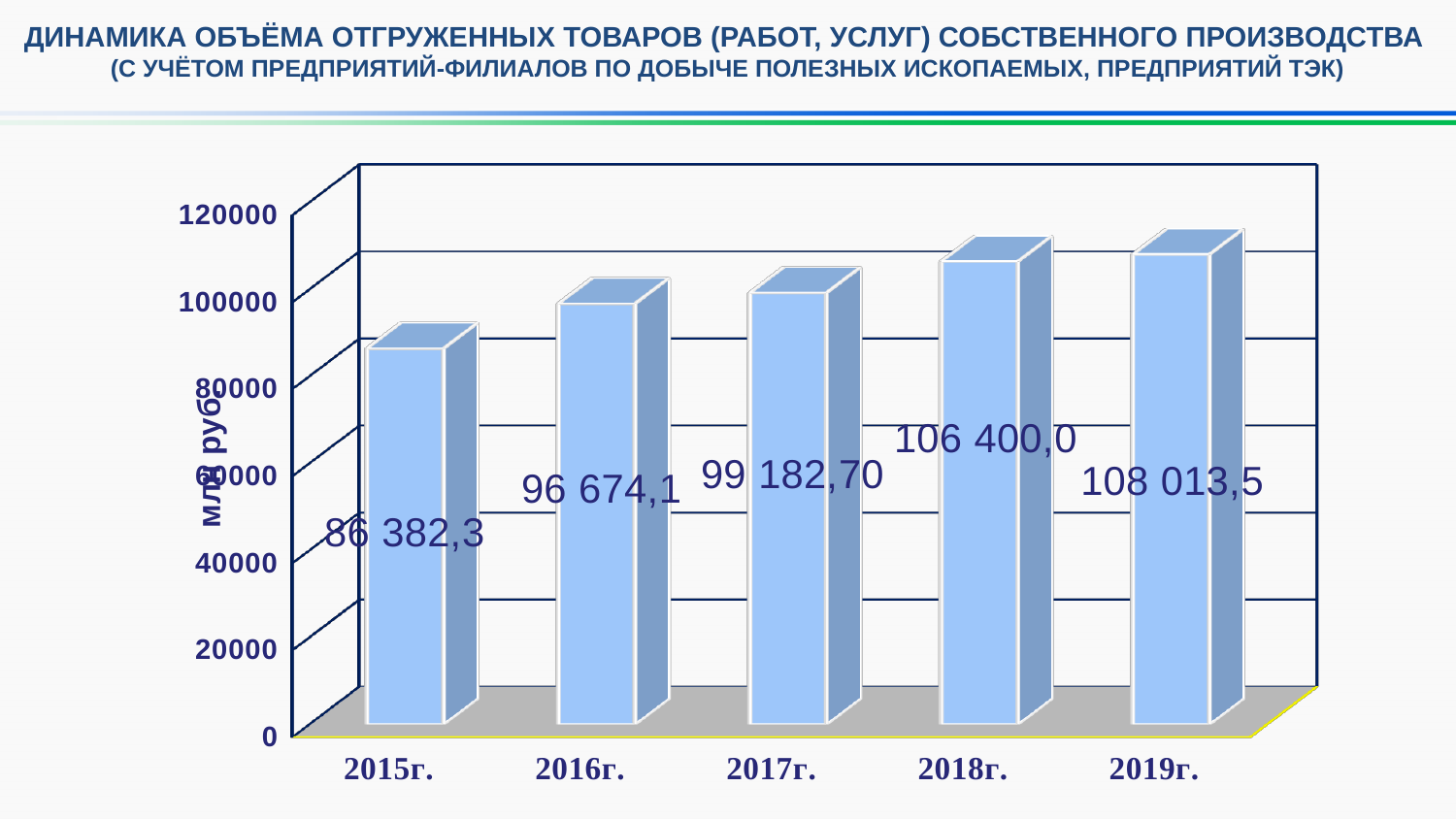
How many years are shown on the x axis? 5 Which is larger, the value for 2017г. or the value for 2018г.? 2018г. Which year has the lowest value? 2015г. Which year has the highest value? 2019г. What is the difference between the values for 2019г. and 2018г.? 1 613,5 What is the value for 2019г.? 108 013,5 Is the value for 2015г. greater or less than 100000? less Do the values rise or fall from 2015г. to 2019г.? rise What is the value for 2017г.? 99 182,70 What kind of chart is shown on the slide? bar chart What is the value for 2015г.? 86 382,3 What is the difference between the values for 2016г. and 2015г.? 10 291,8